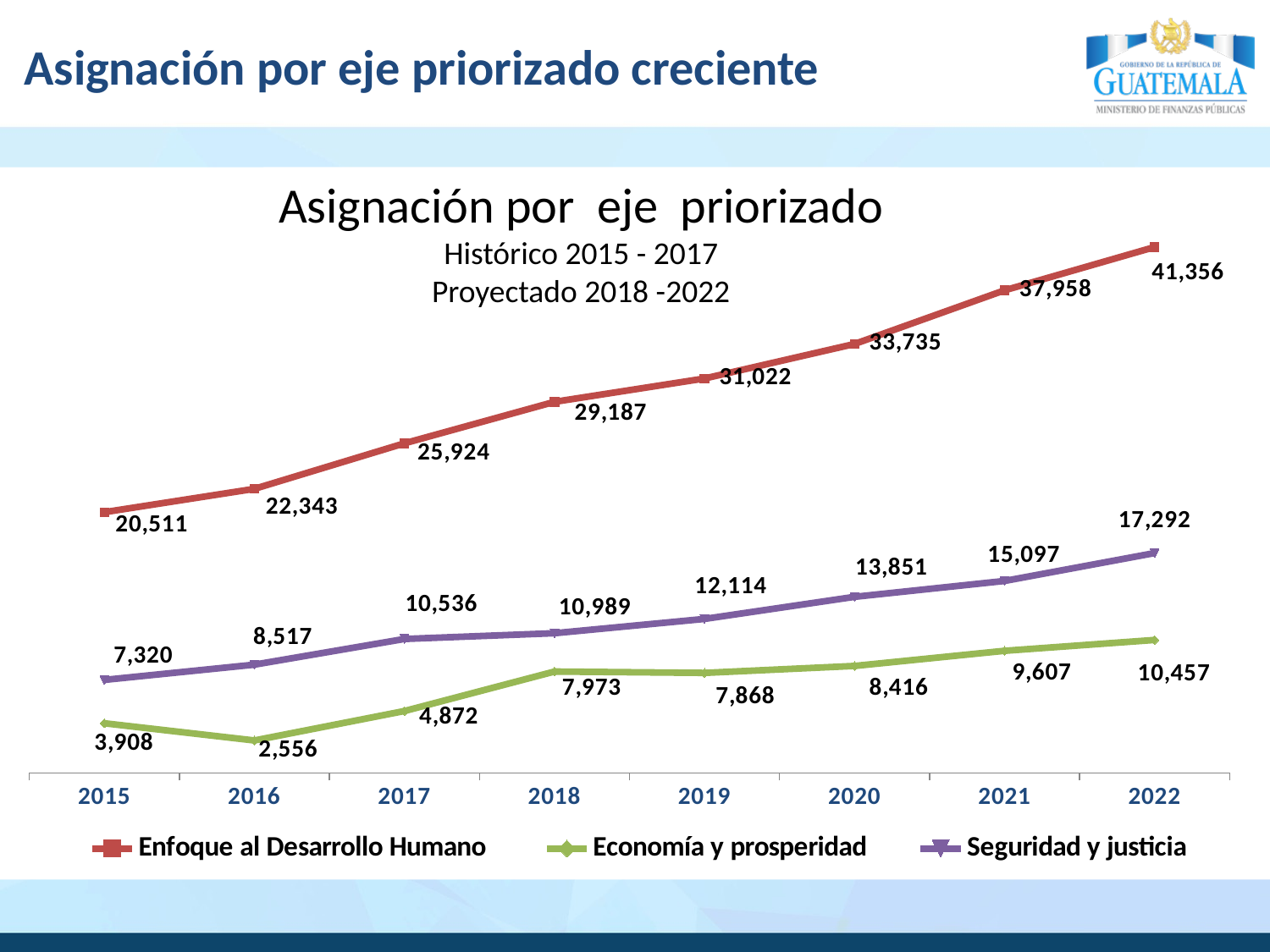
How many series does the legend list? 3 How many years are shown on the x axis? 8 Which series has the larger value in 2020, Seguridad y justicia or Economía y prosperidad? Seguridad y justicia What is the difference between Seguridad y justicia and Economía y prosperidad in 2018? 3,016 What is the value for Seguridad y justicia in 2019? 12,114 In which year is the value for Seguridad y justicia highest? 2022 Does the Enfoque al Desarrollo Humano series rise or fall from 2015 to 2022? Rise What is the value for Enfoque al Desarrollo Humano in 2022? 41,356 What is the value for Economía y prosperidad in 2016? 2,556 What kind of chart is shown on the slide? Line chart What is the difference between the Enfoque al Desarrollo Humano values for 2022 and 2015? 20,845 In which year is the value for Economía y prosperidad lowest? 2016